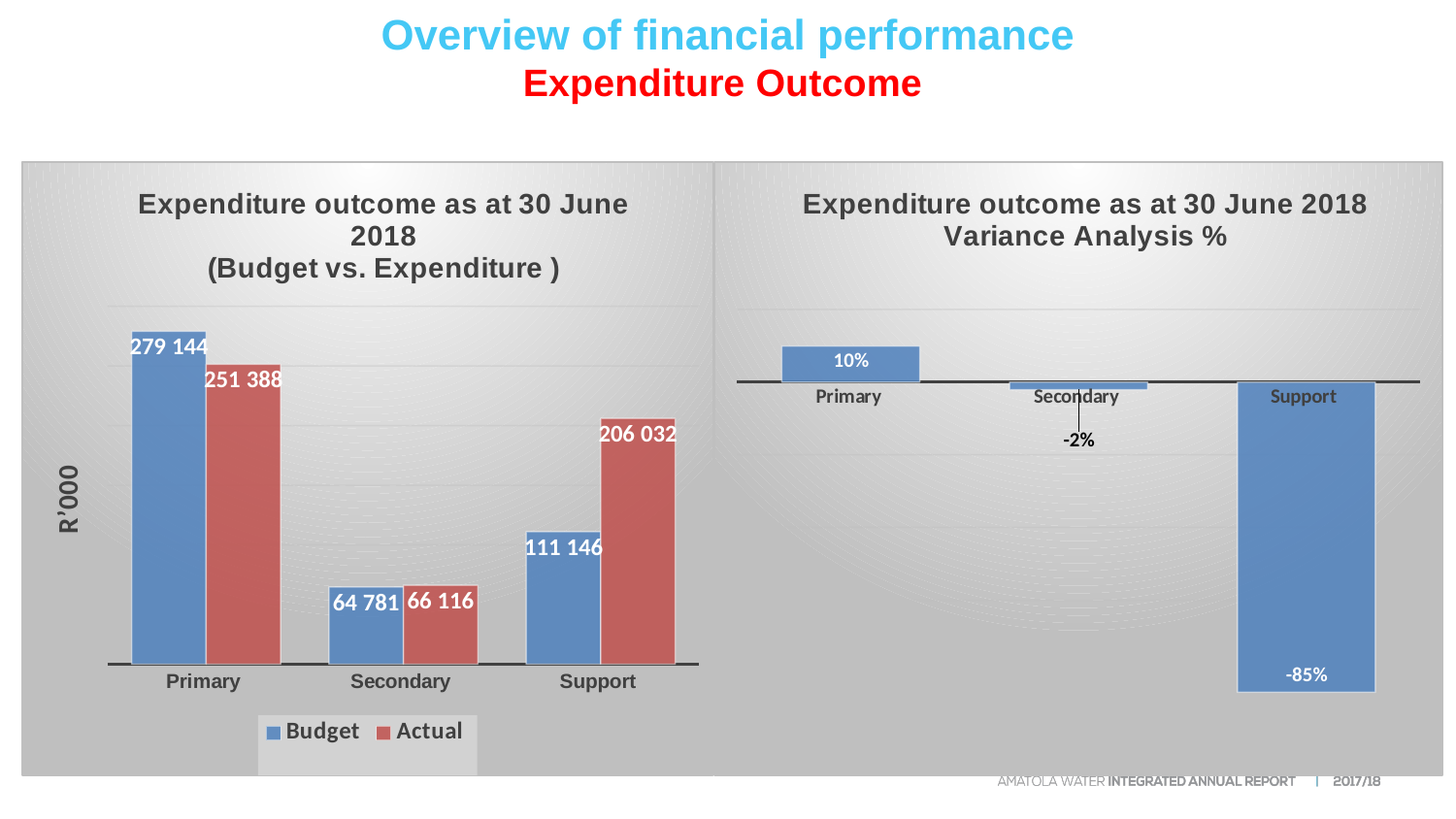
In the right chart (Variance Analysis %), what is the value for Primary? 10% In the left chart (Budget vs. Expenditure), which is larger for Support: Budget or Actual? Actual In the left chart (Budget vs. Expenditure), what is the Actual value for Secondary? 66 116 In the left chart (Budget vs. Expenditure), what is the difference between the Budget and Actual values for Primary? 27 756 In the right chart (Variance Analysis %), what is the value for Support? -85% In the left chart (Budget vs. Expenditure), how many series does the legend list? 2 In the left chart (Budget vs. Expenditure), which category has the lowest Actual value? Secondary In the right chart (Variance Analysis %), how many categories are shown? 3 In the left chart (Budget vs. Expenditure), what is the Actual value for Support? 206 032 In the left chart (Budget vs. Expenditure), what is the Budget value for Primary? 279 144 In the left chart (Budget vs. Expenditure), which category has the highest Budget value? Primary In the left chart (Budget vs. Expenditure), what kind of chart is shown? Bar chart